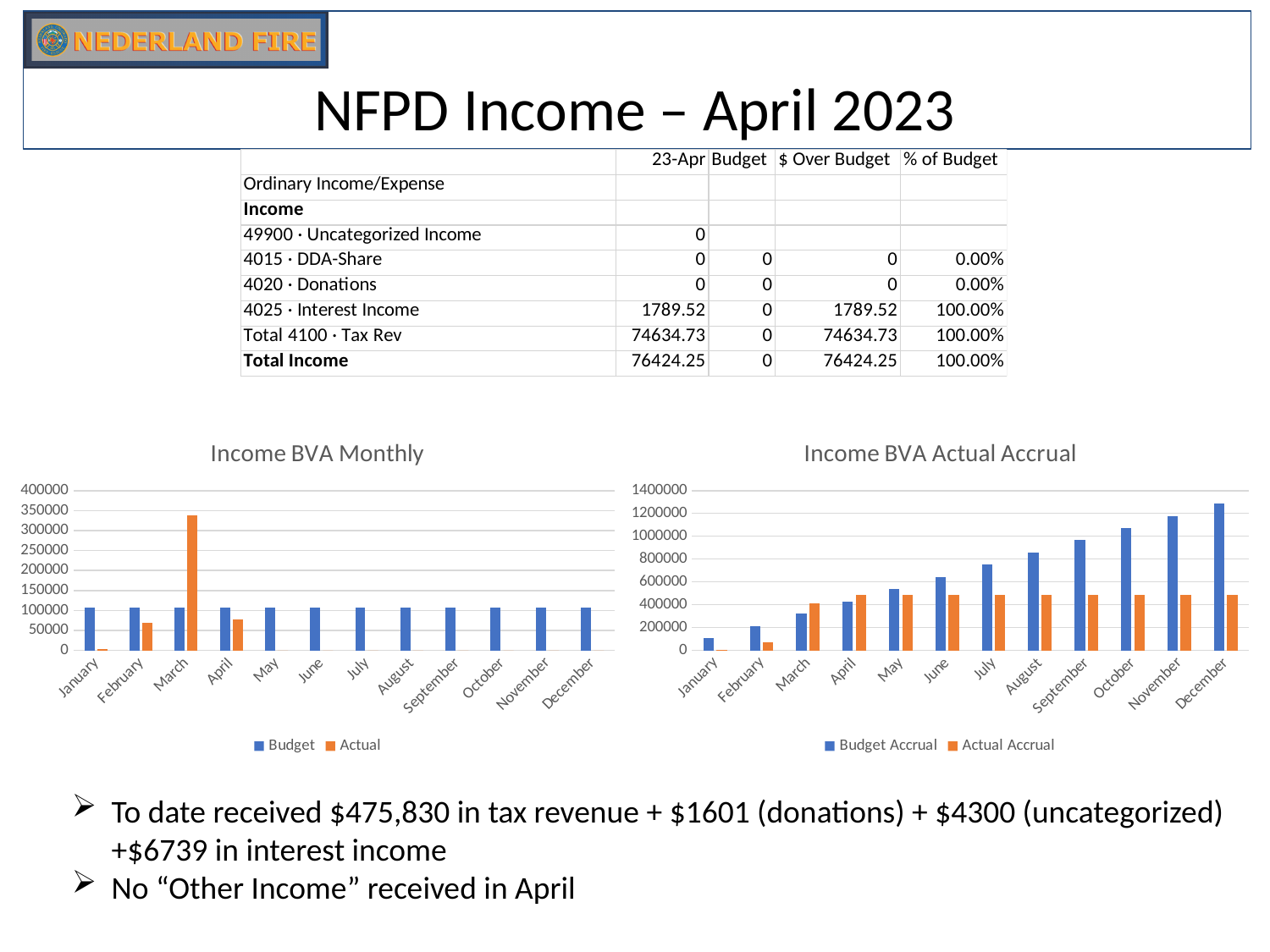
In the "Income BVA Actual Accrual" chart, do the Budget Accrual values rise or fall from January to December? rise What are the two legend entries of the "Income BVA Monthly" chart? Budget and Actual In the "Income BVA Monthly" chart, which month has the highest Actual value? March What kind of chart is the "Income BVA Monthly" chart? bar chart In the "Income BVA Monthly" chart, is the Actual value for March greater or less than 300000? greater In the "Income BVA Monthly" chart, which is larger for March, Budget or Actual? Actual In the "Income BVA Actual Accrual" chart, which is larger for December, Budget Accrual or Actual Accrual? Budget Accrual In the "Income BVA Actual Accrual" chart, is the Actual Accrual value for December greater or less than 600000? less How many months are shown on the x axis of the "Income BVA Monthly" chart? 12 How many series does the legend of the "Income BVA Actual Accrual" chart list? 2 In the "Income BVA Actual Accrual" chart, is the Budget Accrual value for December greater or less than 1200000? greater What is the title of the chart on the right side of the slide? Income BVA Actual Accrual